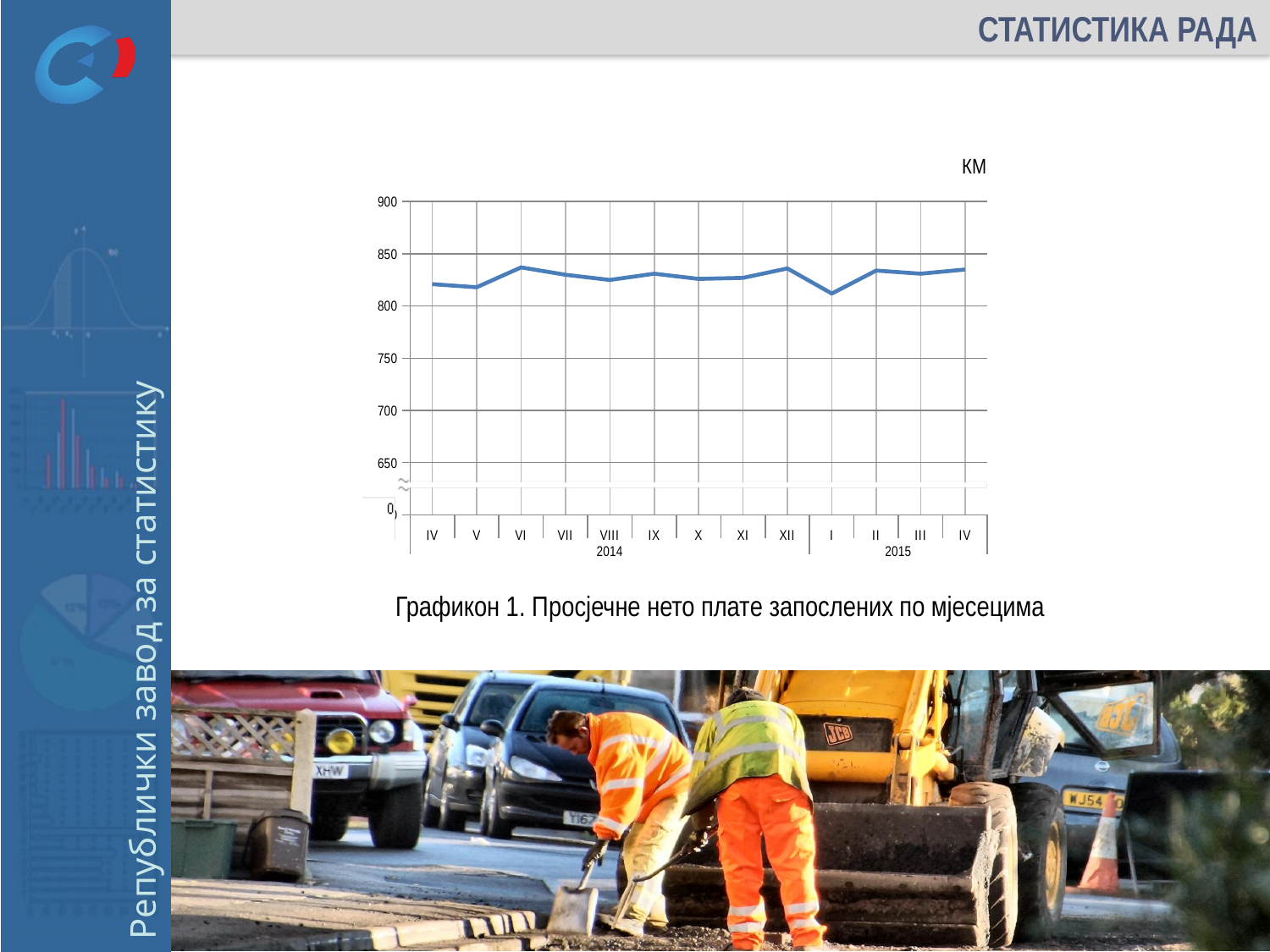
Is the value for IV 2014 greater or less than 850? less Is the value for VI 2014 greater or less than 800? greater What is the title of the chart on the slide? Графикон 1. Просјечне нето плате запослених по мјесецима What unit is shown above the vertical axis of the chart? KM Which month has the lowest average net wage on the chart? I 2015 Is the value for I 2015 greater or less than 850? less Does the value rise or fall from XII 2014 to I 2015? fall How many monthly data points are plotted on the chart? 13 Which is larger, the value for VI 2014 or the value for I 2015? VI 2014 Which is larger, the value for IV 2014 or the value for VI 2014? VI 2014 Does the value rise or fall from I 2015 to II 2015? rise What kind of chart is shown on the slide? line chart